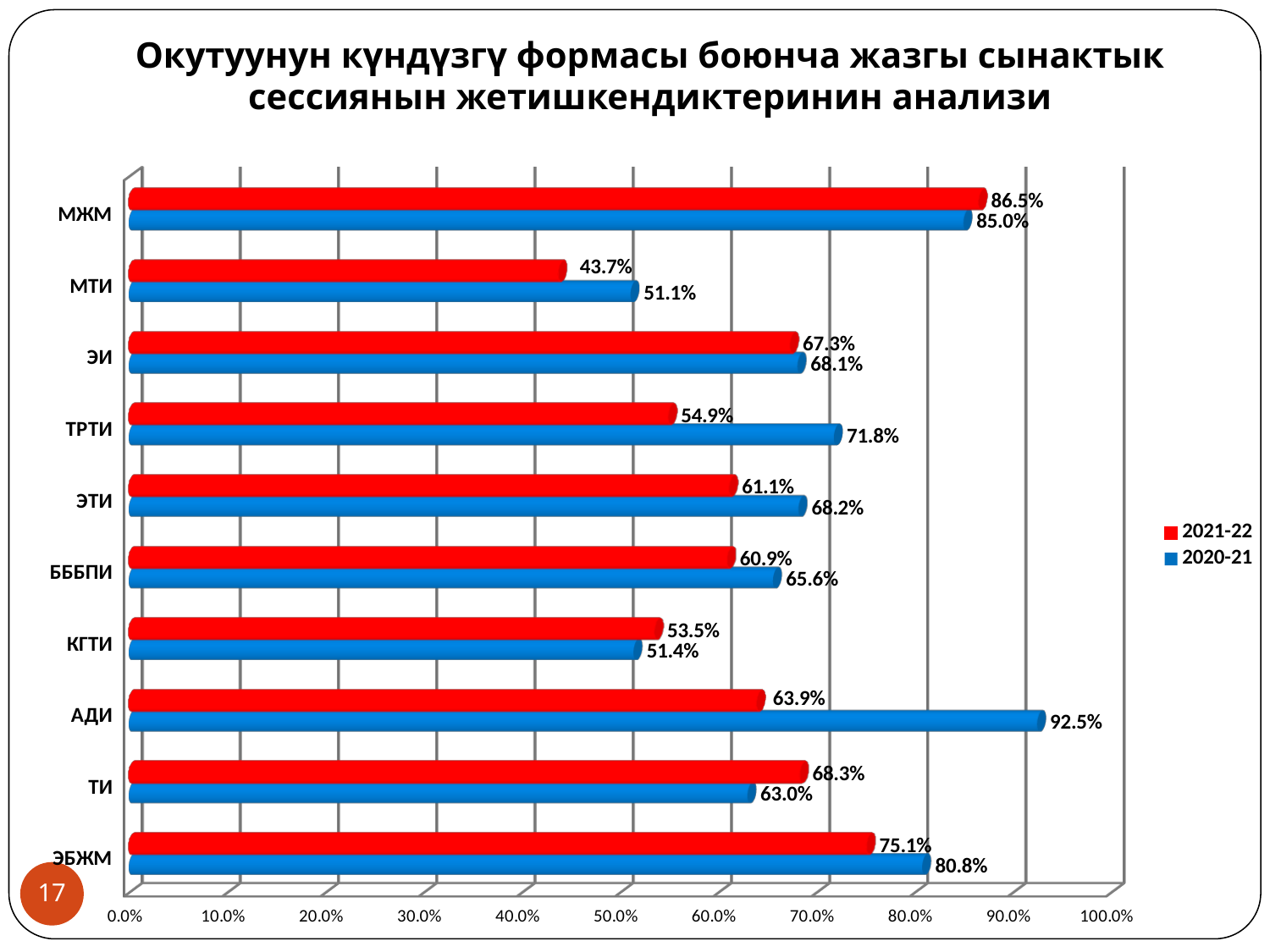
Which category has the lowest 2020-21 value? МТИ Which category has the highest 2020-21 value? АДИ How many series does the legend list? 2 How many categories are shown on the chart? 10 What is the 2021-22 value for МЖМ? 86.5% What type of chart is shown on the slide? bar chart What is the difference between the 2020-21 and 2021-22 values for АДИ? 28.6% What is the 2020-21 value for АДИ? 92.5% Which category has the highest 2021-22 value? МЖМ For ТРТИ, which is larger: the 2021-22 value or the 2020-21 value? 2020-21 What is the 2021-22 value for МТИ? 43.7% Which colour represents the 2021-22 series in the legend? red